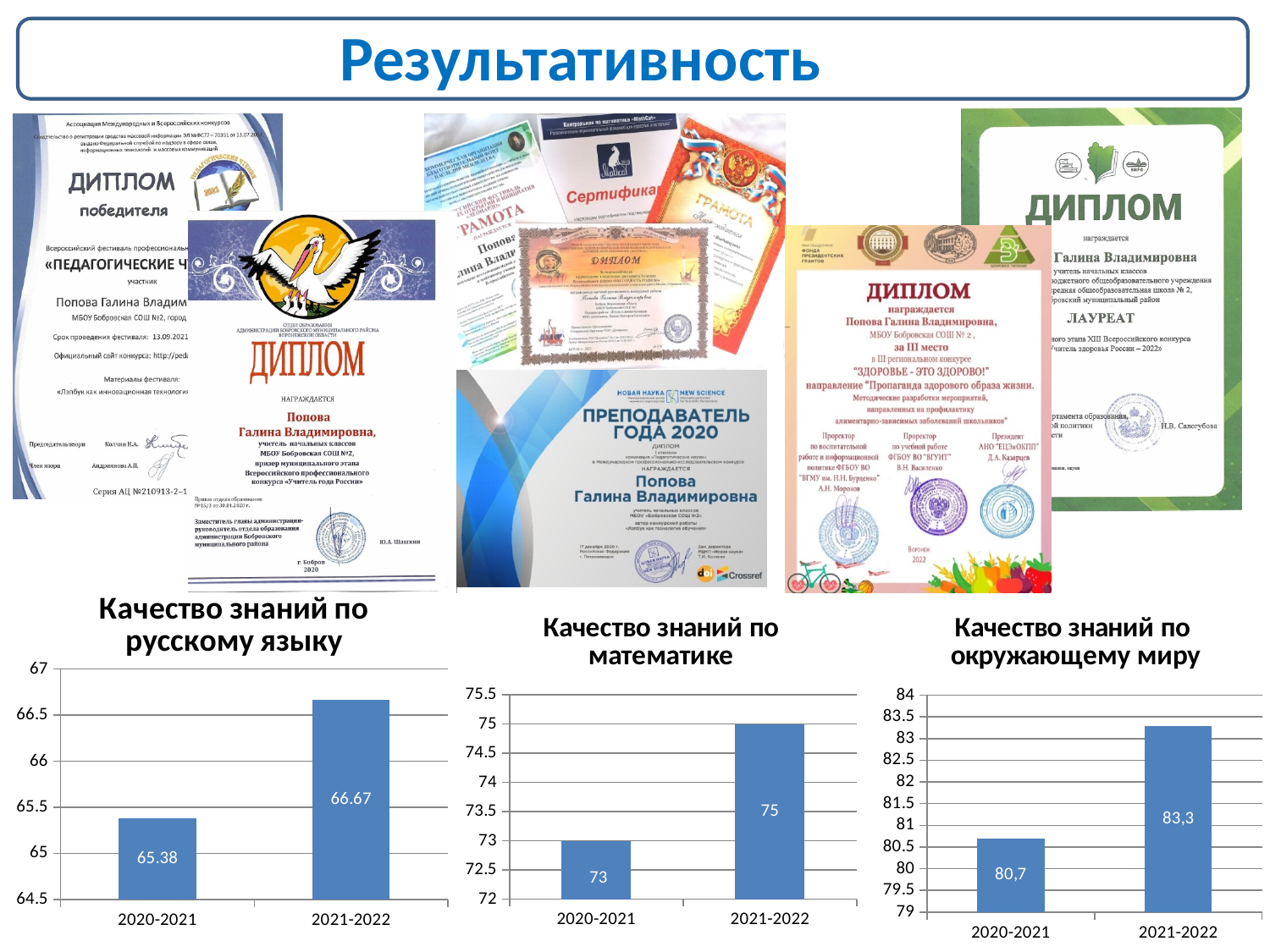
In the chart 'Качество знаний по окружающему миру', which year has the lowest value? 2020-2021 In the chart 'Качество знаний по русскому языку', what is the value for 2020-2021? 65.38 In the chart 'Качество знаний по окружающему миру', what is the value for 2021-2022? 83,3 In the chart 'Качество знаний по математике', do the values rise or fall from 2020-2021 to 2021-2022? rise How many categories are shown on the x axis of the chart 'Качество знаний по окружающему миру'? 2 In the chart 'Качество знаний по математике', what is the value for 2020-2021? 73 In the chart 'Качество знаний по математике', what is the difference between the 2021-2022 and 2020-2021 values? 2 In the chart 'Качество знаний по математике', what is the value for 2021-2022? 75 In the chart 'Качество знаний по русскому языку', what is the value for 2021-2022? 66.67 What kind of chart is 'Качество знаний по русскому языку'? bar chart In the chart 'Качество знаний по русскому языку', which year has the higher value? 2021-2022 In the chart 'Качество знаний по окружающему миру', what is the value for 2020-2021? 80,7